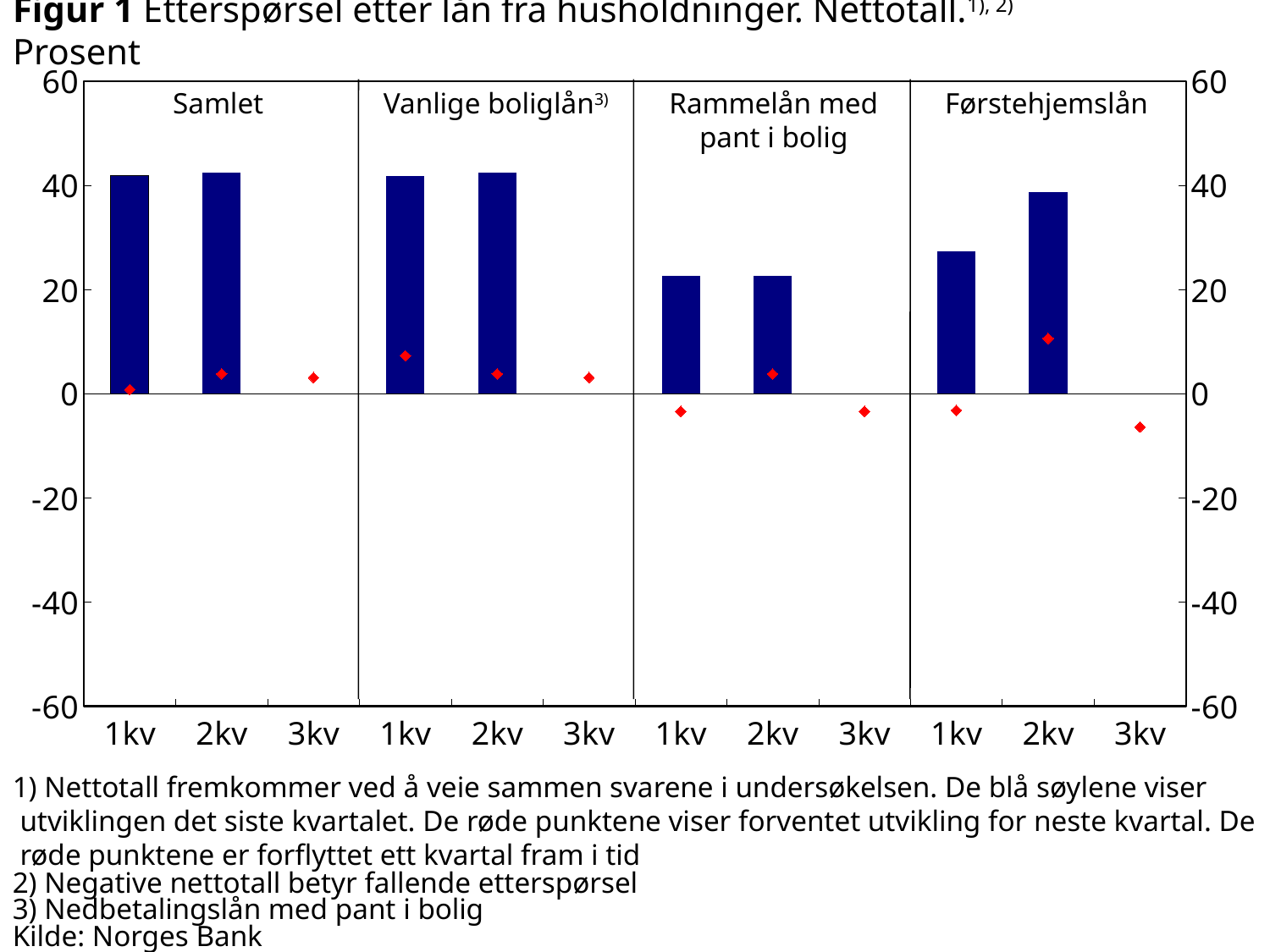
What colour are the bars in the chart? Blue How many quarters are labelled on the x axis within each panel? 3 Do the blue bars in the Førstehjemslån panel rise or fall from 1kv to 2kv? rise Is the blue bar for 1kv in the Førstehjemslån panel greater or less than 40? less What is the source cited below the chart? Norges Bank Is the blue bar for 1kv in the Rammelån med pant i bolig panel greater or less than 40? less What kind of chart is shown on the slide? Bar chart Is the blue bar for 1kv in the Samlet panel greater or less than 20? greater In the Førstehjemslån panel, which quarter has the taller blue bar, 1kv or 2kv? 2kv Which panel has the lowest blue bars overall? Rammelån med pant i bolig How many loan-category panels does the chart have? 4